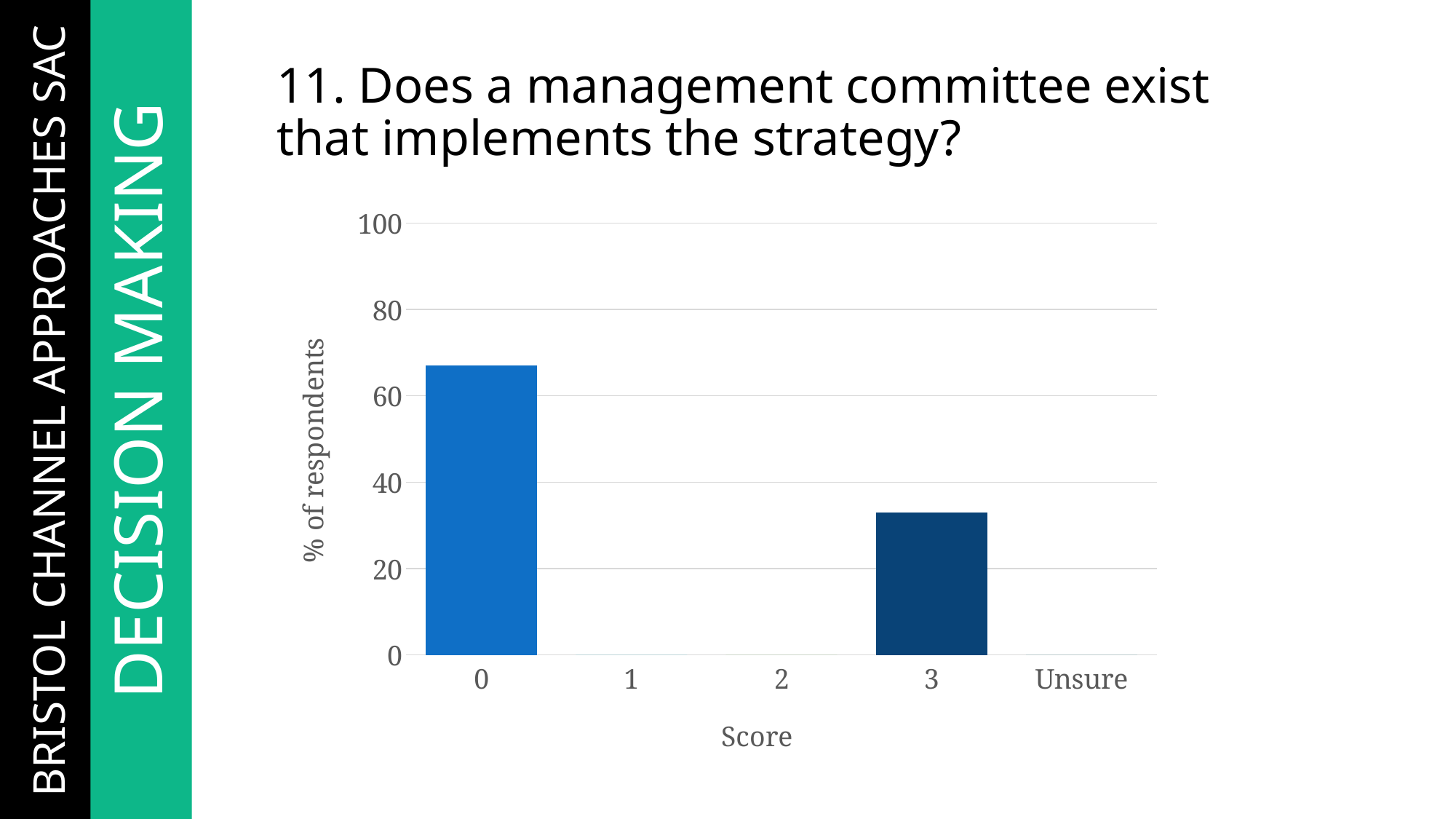
Which is larger, the value for score 0 or the value for score 3? score 0 Which score category has the highest percentage of respondents? 0 What is the percentage of respondents for score 1? 0 Is the value for score 3 greater or less than 20? greater Is the value for score 0 greater or less than 80? less Is the value for score 0 greater or less than 60? greater What kind of chart is shown on the slide? bar chart What is the label of the y axis of the chart? % of respondents What is the percentage of respondents for the Unsure category? 0 How many score categories are shown on the x axis of the chart? 5 What is the label of the x axis of the chart? Score